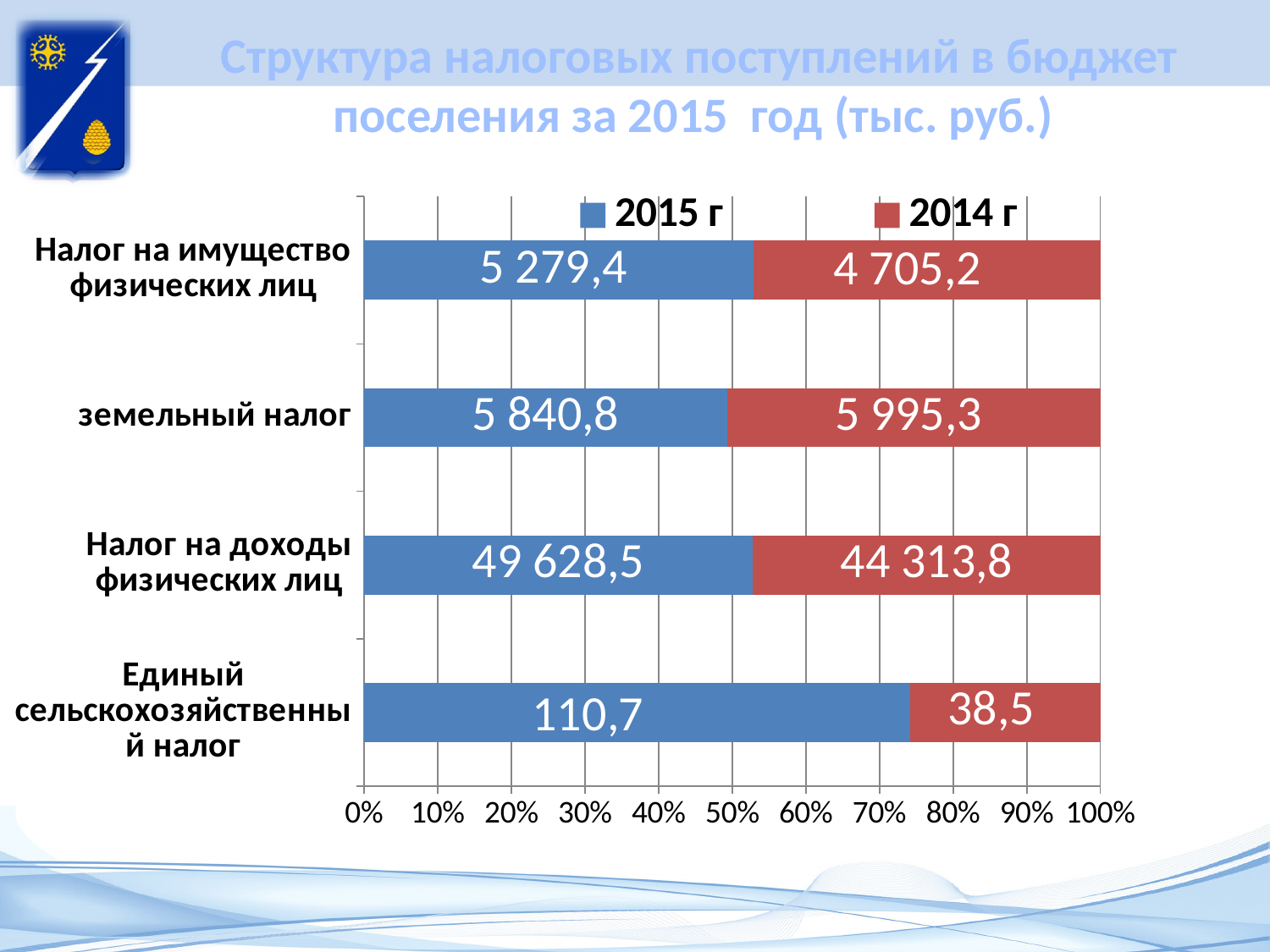
What is the difference between the 2015 г and 2014 г values for Налог на имущество физических лиц? 574,2 What is the difference between the 2015 г and 2014 г values for Налог на доходы физических лиц? 5 314,7 How many categories are shown on the chart? 4 Which category has the lowest 2014 г value? Единый сельскохозяйственный налог How many series does the legend list? 2 What is the 2015 г value for Налог на доходы физических лиц? 49 628,5 Which category has the highest 2015 г value? Налог на доходы физических лиц What is the 2015 г value for Налог на имущество физических лиц? 5 279,4 Is the 2015 г share of the bar for Единый сельскохозяйственный налог greater or less than 70%? greater What is the 2014 г value for земельный налог? 5 995,3 What is the 2014 г value for Единый сельскохозяйственный налог? 38,5 For земельный налог, which is larger: the 2015 г value or the 2014 г value? 2014 г